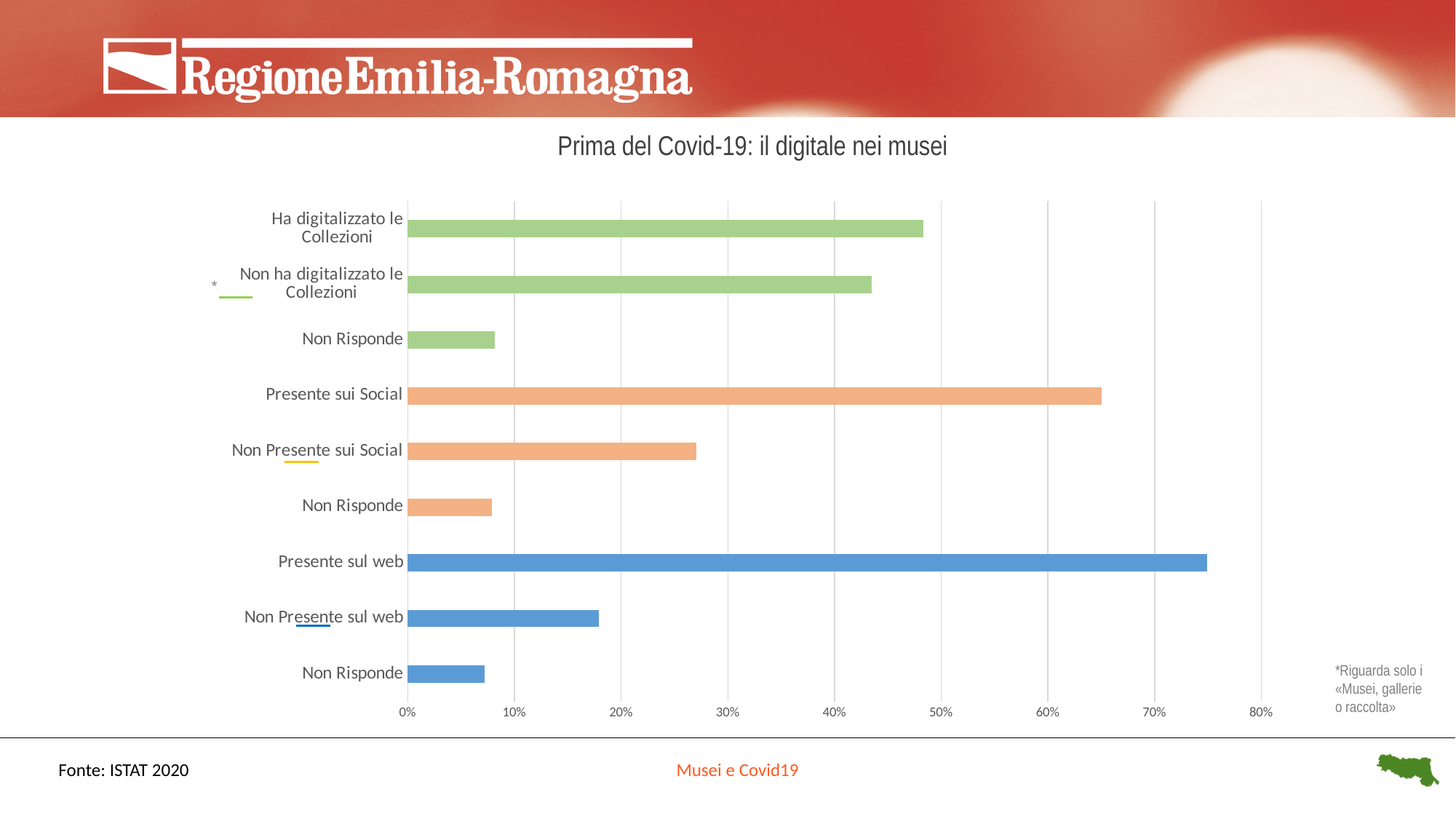
What is the title of the chart? Prima del Covid-19: il digitale nei musei Is the value for Non ha digitalizzato le Collezioni greater or less than 50%? less Is the value for Presente sui Social greater or less than 60%? greater Is the value for Presente sul web greater or less than 70%? greater Which is larger, the value for Ha digitalizzato le Collezioni or the value for Non ha digitalizzato le Collezioni? Ha digitalizzato le Collezioni What kind of chart is shown on the slide? bar chart How many bars are plotted in the chart? 9 Which is larger, the value for Presente sui Social or the value for Non Presente sui Social? Presente sui Social Which category has the highest value in the chart? Presente sul web